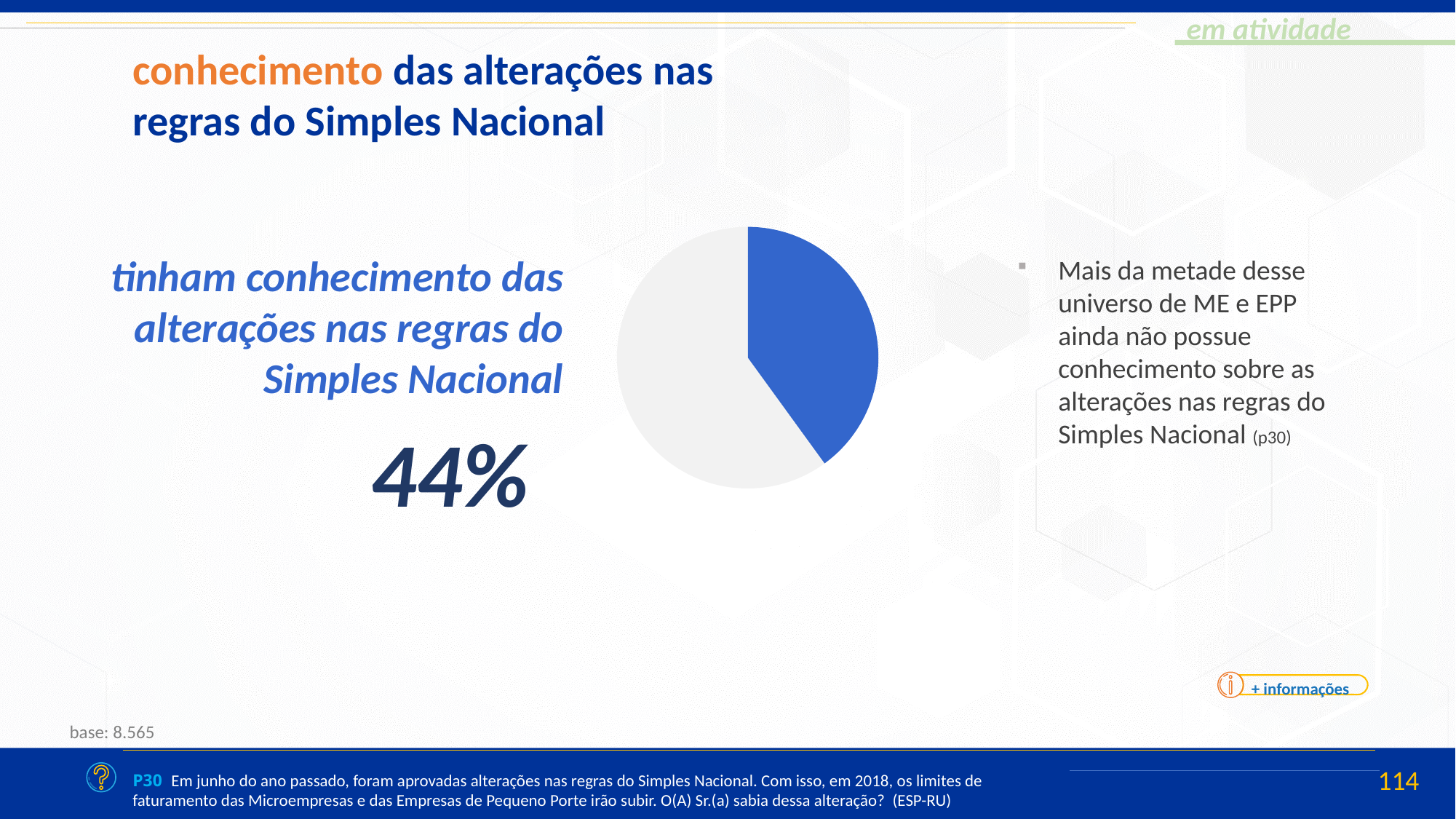
Which slice of the pie chart is larger, the blue slice or the grey slice? grey slice What kind of chart is shown on the slide? pie chart What share of respondents had knowledge of the changes in the Simples Nacional rules, according to the pie chart? 44% Is the blue slice of the pie chart greater or less than half of the pie? less What colour is the pie slice representing those who knew about the changes in the Simples Nacional rules? blue How many slices does the pie chart have? 2 What is the base (number of respondents) stated for the chart? 8.565